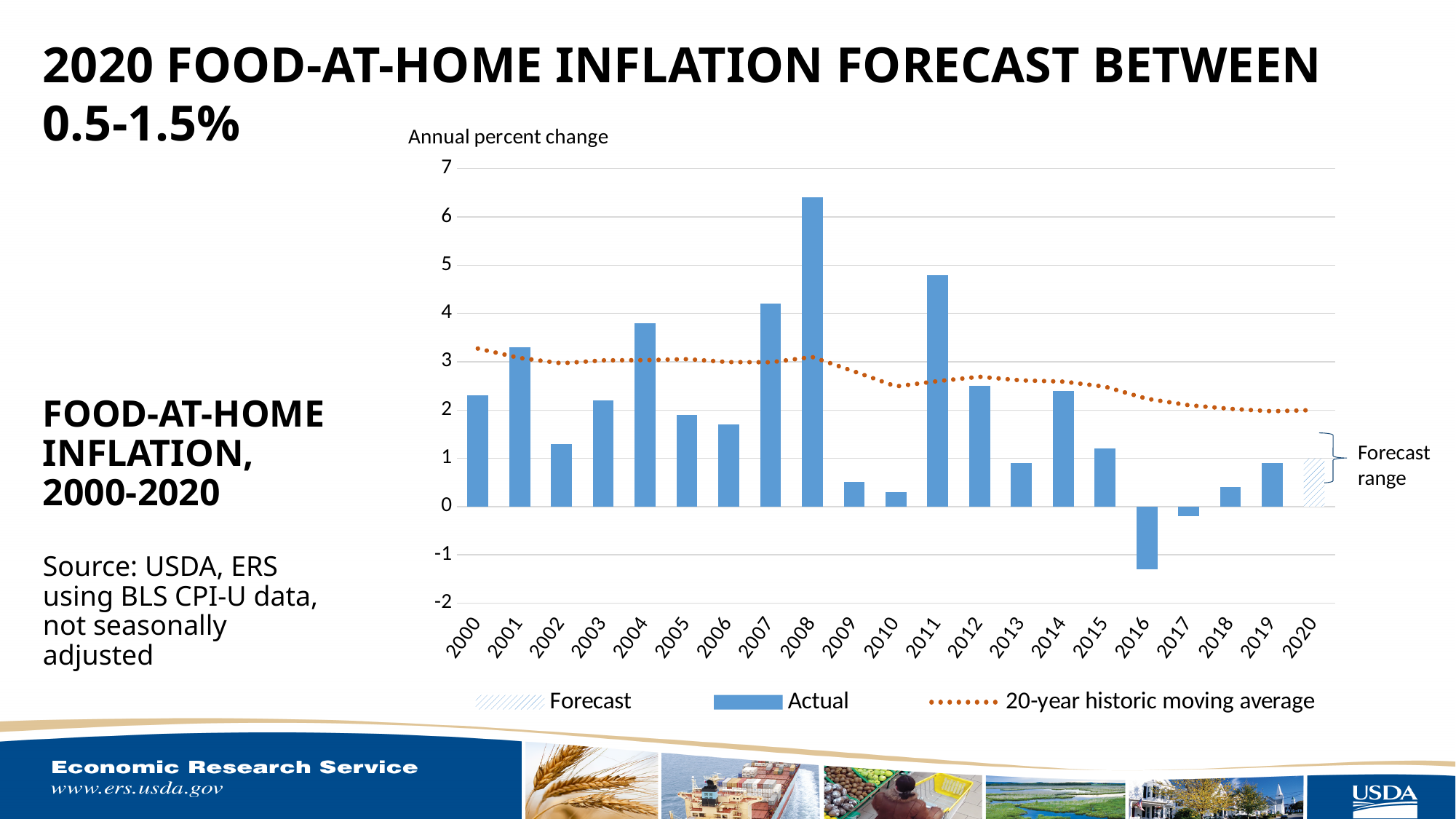
Is the actual value for 2016 greater or less than -1? less How many years are shown on the x axis? 21 What is the forecast range for 2020 food-at-home inflation? 0.5-1.5% Which year has the lowest actual food-at-home inflation? 2016 Which year has the highest actual food-at-home inflation? 2008 Is the actual value for 2010 greater or less than 1? less Which year has the larger actual value, 2008 or 2011? 2008 What type of chart is used to show food-at-home inflation from 2000 to 2020? Combination bar and line chart Is the actual value for 2008 greater or less than 6? greater Which year has the larger actual value, 2004 or 2007? 2007 How many series does the legend list? 3